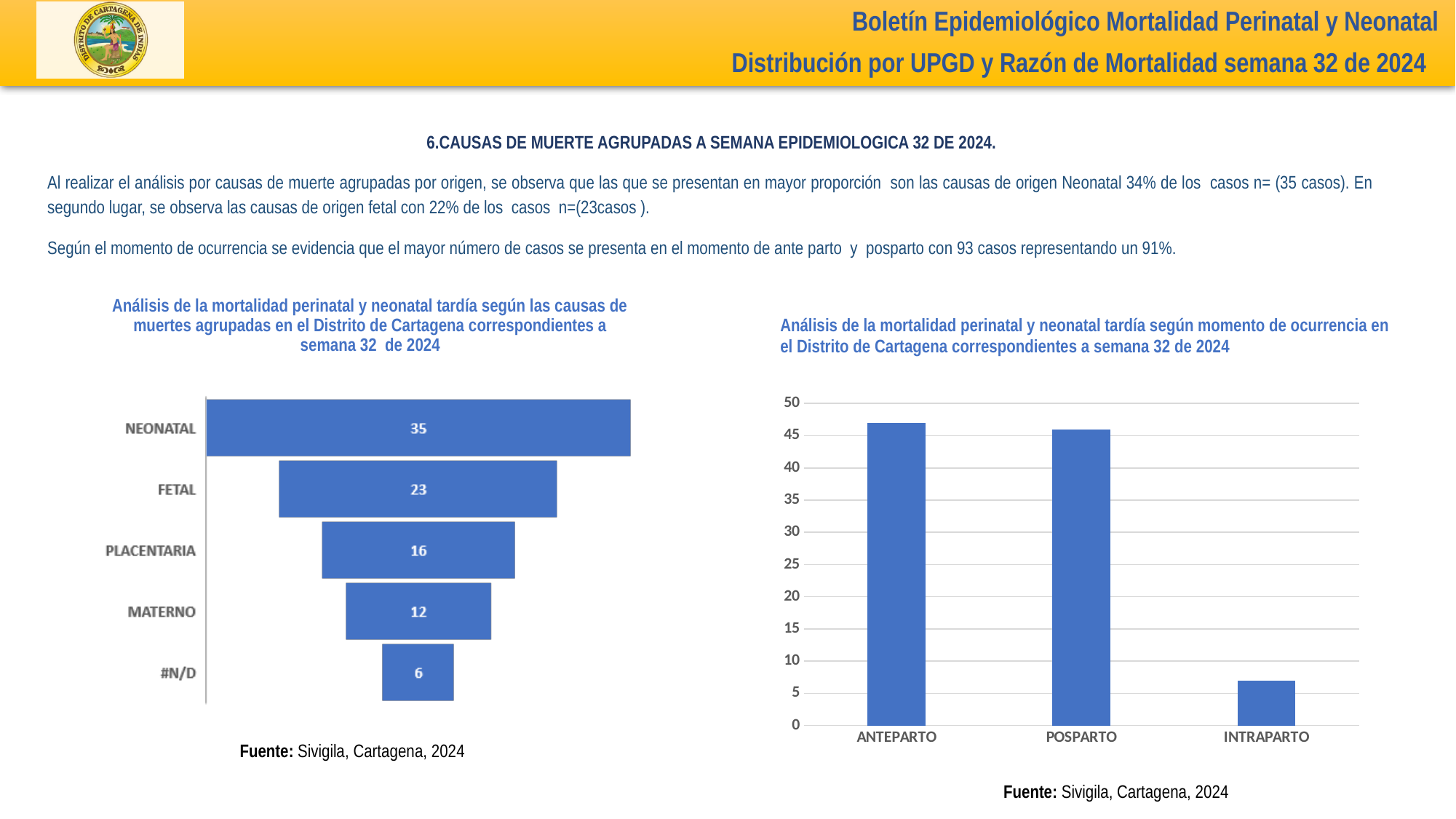
In the left chart on causes of death, what is the value for NEONATAL? 35 In the left chart on causes of death, what is the value for PLACENTARIA? 16 In the left chart on causes of death, which category has the lowest value? #N/D In the left chart on causes of death, which is larger, the value for FETAL or the value for PLACENTARIA? FETAL In the right chart on moment of occurrence, which category has the lowest value? INTRAPARTO In the left chart on causes of death, what is the difference between the values for FETAL and MATERNO? 11 How many categories are shown in the left chart on causes of death? 5 In the right chart on moment of occurrence, is the value for ANTEPARTO greater or less than 40? greater What kind of chart is the right chart on moment of occurrence? Bar chart In the left chart on causes of death, what is the value for #N/D? 6 In the right chart on moment of occurrence, is the value for INTRAPARTO greater or less than 10? less In the left chart on causes of death, which category has the highest value? NEONATAL